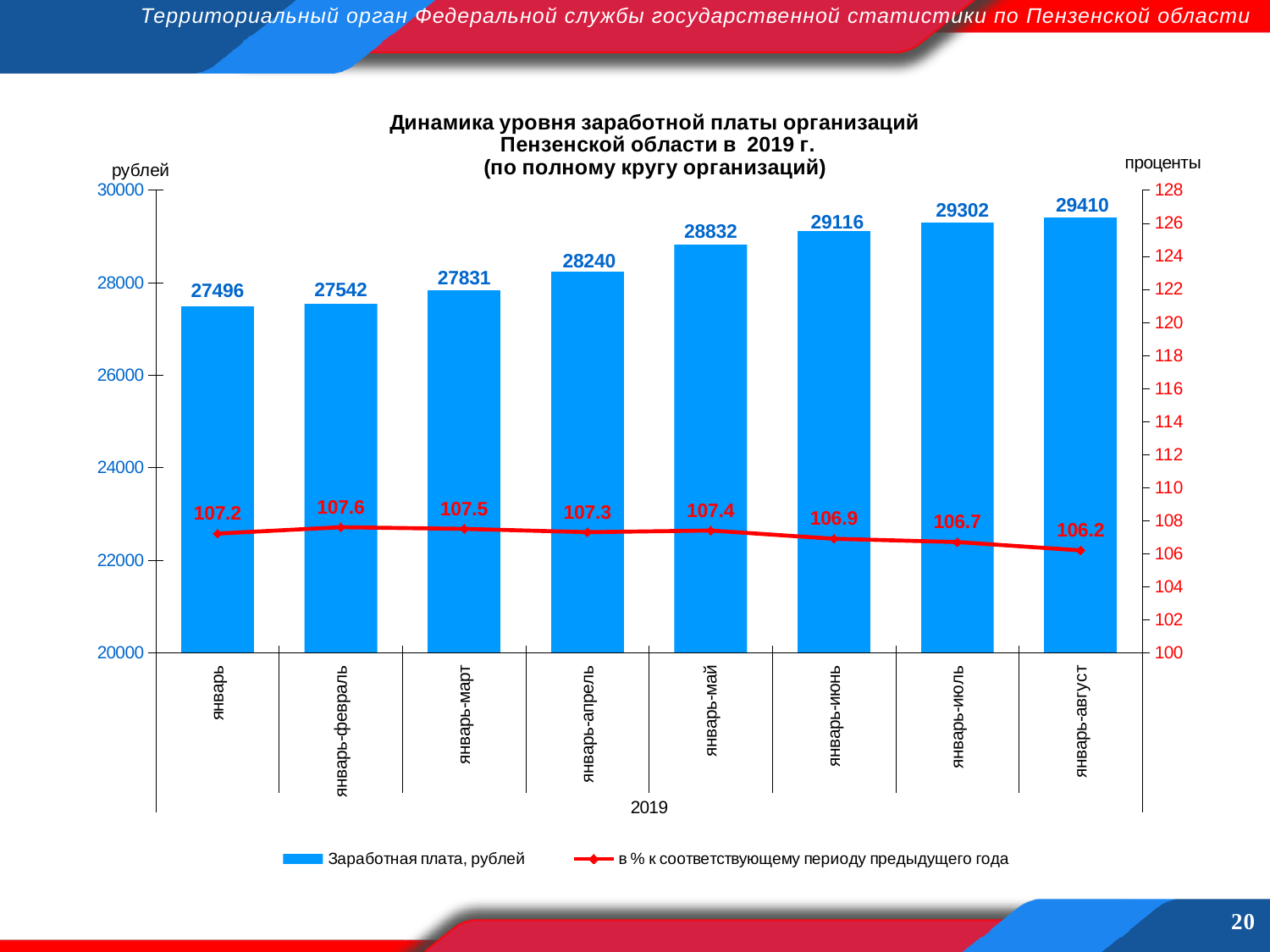
How many series does the legend list? 2 What is the label of the right-hand vertical axis? проценты Which period has the highest wage value? январь-август How many periods are shown on the x axis? 8 Do the wage values rise or fall from январь to январь-август? rise Which period has the lowest value on the line series (в % к соответствующему периоду предыдущего года)? январь-август Is the wage value for январь-июнь greater or less than 28000? greater What is the difference between the wage values for январь-август and январь? 1914 What kind of chart is this? Combined bar and line chart Which is larger, the wage value for январь-март or for январь-апрель? январь-апрель What is the wage value (Заработная плата, рублей) for январь-май? 28832 What is the value of the line series (в % к соответствующему периоду предыдущего года) for январь-февраль? 107.6